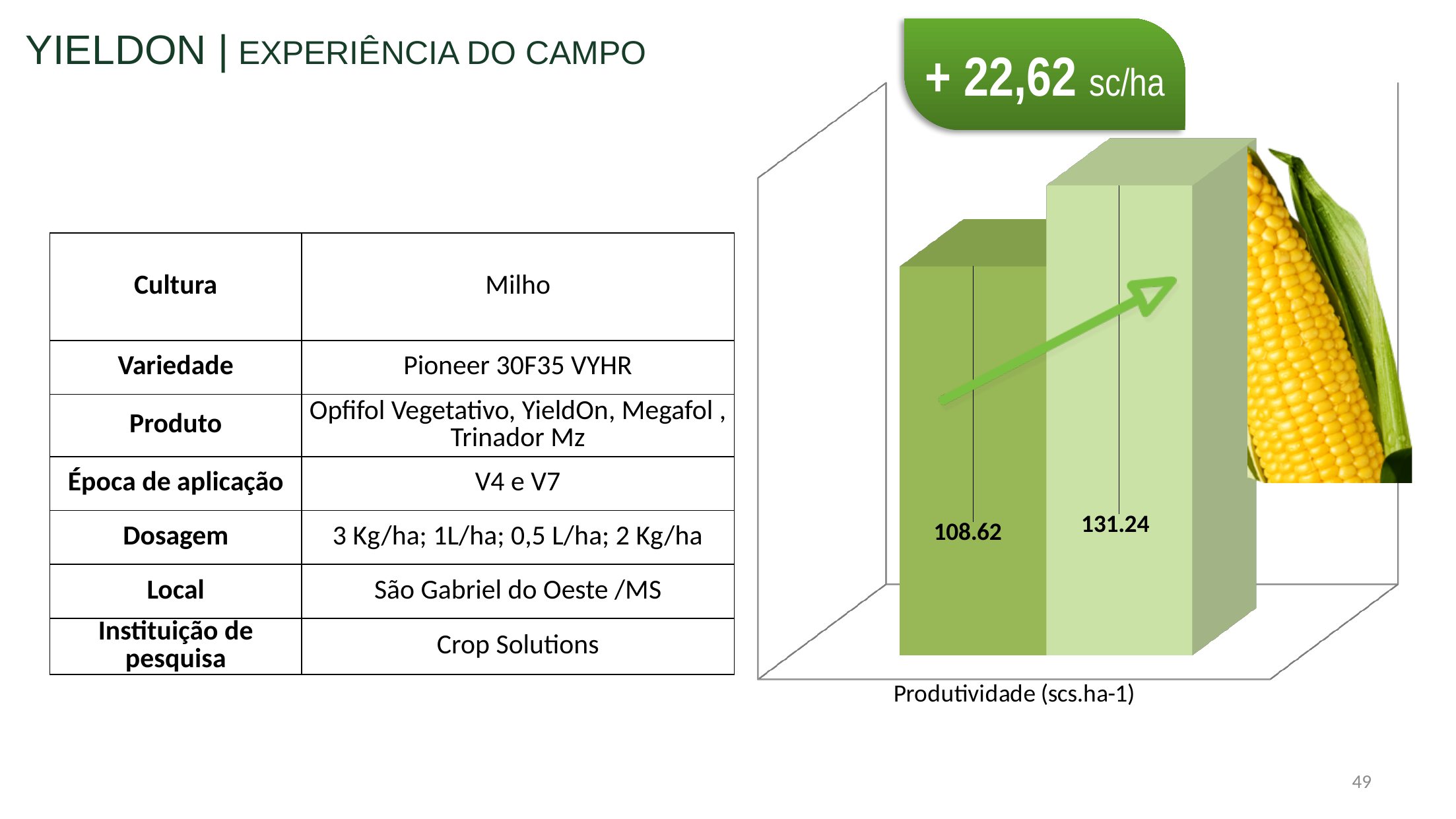
Which bar in the chart has the higher value, the left or the right? the right bar What gain is stated in the green callout above the chart? + 22,62 sc/ha What is the axis label printed below the chart? Produtividade (scs.ha-1) What value is printed on the left bar of the chart? 108.62 What is the difference between the right bar (131.24) and the left bar (108.62)? 22.62 What kind of chart is shown on the slide? bar chart What value is printed on the right bar of the chart? 131.24 Is the value of the right bar larger or smaller than the value of the left bar? larger How many bars are plotted in the chart? 2 Do the bar values rise or fall from left to right? rise Which bar in the chart has the lower value, the left or the right? the left bar